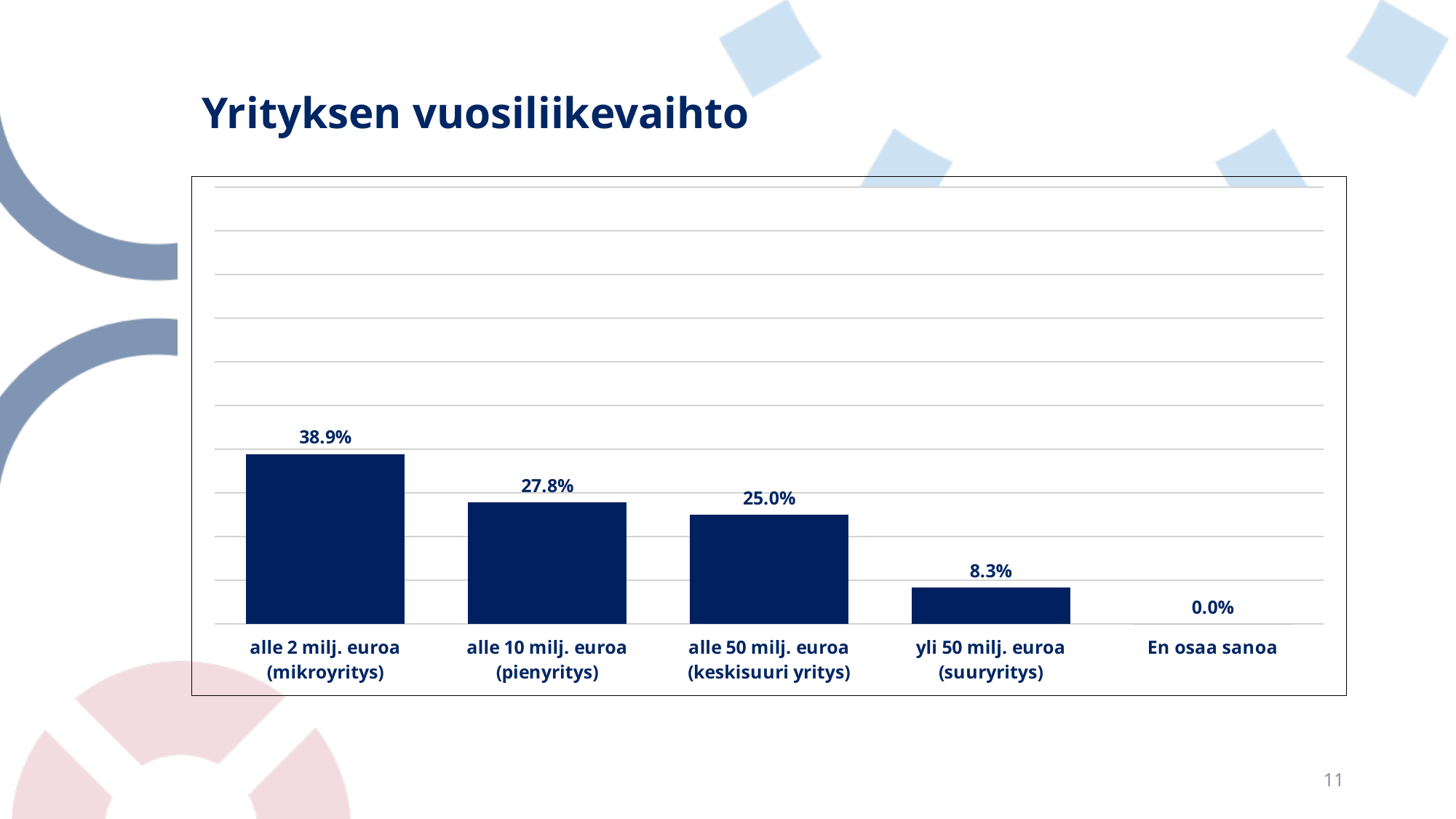
What is the value for 'yli 50 milj. euroa (suuryritys)'? 8.3% What is the value for 'En osaa sanoa'? 0.0% What is the value for 'alle 10 milj. euroa (pienyritys)'? 27.8% What is the value for 'alle 50 milj. euroa (keskisuuri yritys)'? 25.0% Which is larger: the value for 'alle 10 milj. euroa (pienyritys)' or 'alle 50 milj. euroa (keskisuuri yritys)'? alle 10 milj. euroa (pienyritys) What is the title of the slide? Yrityksen vuosiliikevaihto What kind of chart is shown on the slide? bar chart What is the difference between the values for 'alle 2 milj. euroa (mikroyritys)' and 'alle 10 milj. euroa (pienyritys)'? 11.1% Which category has the lowest value? En osaa sanoa How many categories are shown on the x axis? 5 What is the value for 'alle 2 milj. euroa (mikroyritys)'? 38.9% Which category has the highest value? alle 2 milj. euroa (mikroyritys)